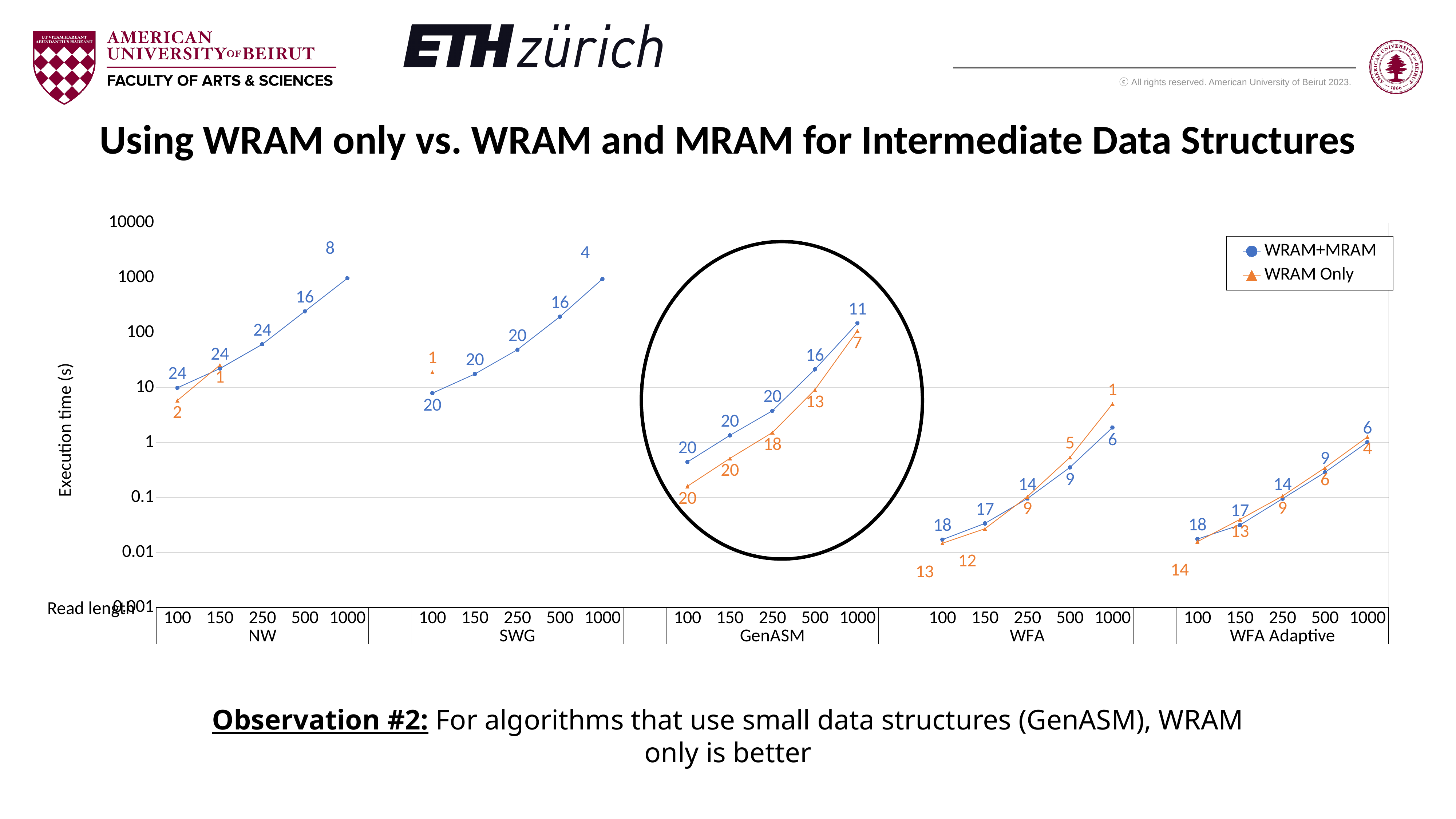
What are the two series named in the legend? WRAM+MRAM and WRAM Only Which algorithm group is circled on the chart? GenASM Is the WRAM+MRAM execution time for GenASM at read length 1000 greater or less than 100? greater For NW, does the WRAM+MRAM execution time rise or fall as read length increases from 100 to 1000? rise How many algorithm groups are shown along the x axis? 5 What kind of chart is shown on the slide? line chart How many series does the legend list? 2 Is the WRAM+MRAM execution time for NW at read length 500 greater or less than 100? greater For GenASM at read length 250, which series has the larger execution time, WRAM+MRAM or WRAM Only? WRAM+MRAM Is the WRAM Only execution time for WFA at read length 1000 greater or less than 1? greater For SWG at read length 100, which series has the larger execution time, WRAM+MRAM or WRAM Only? WRAM Only